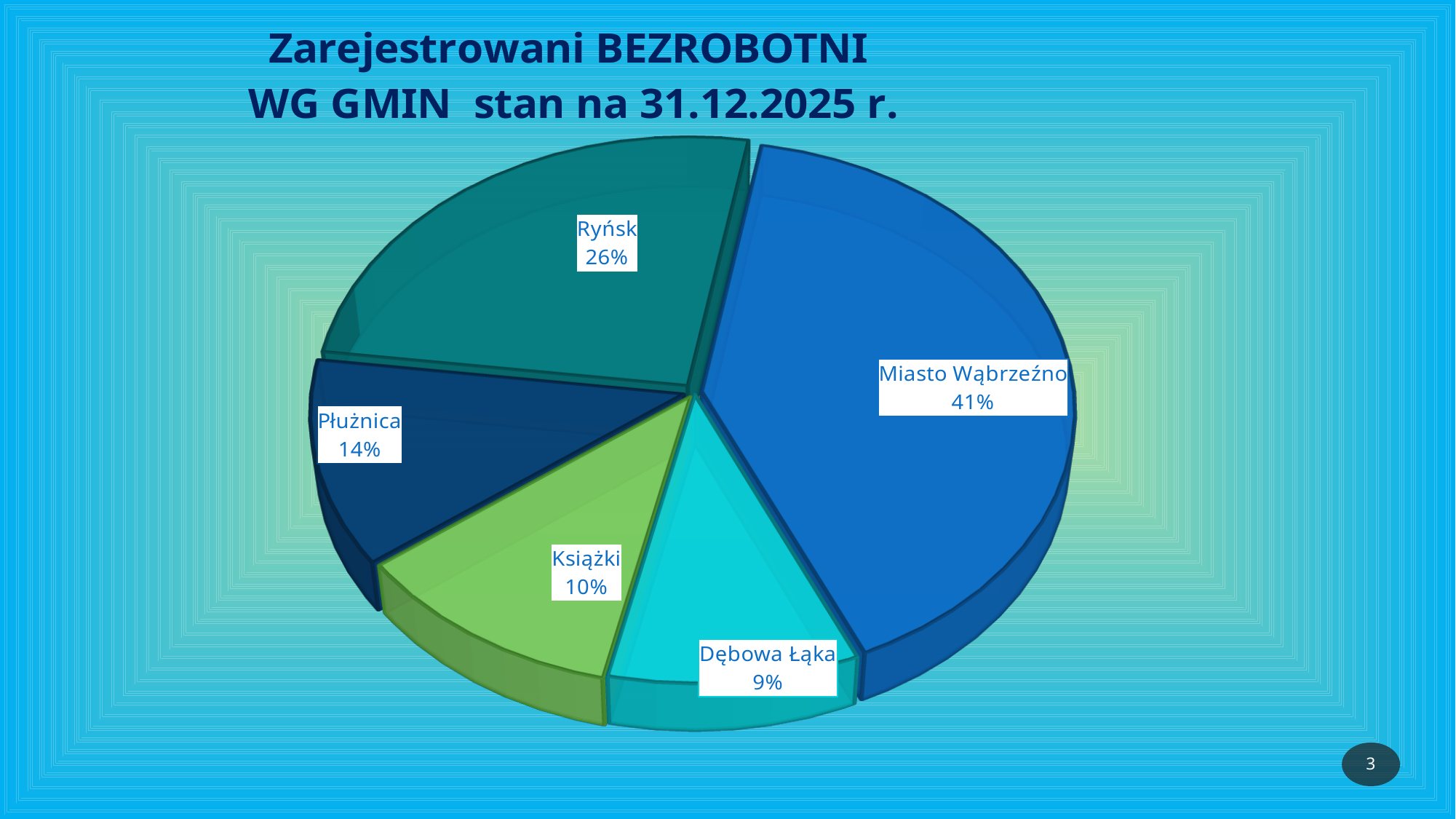
What percentage is shown for Ryńsk? 26% What is the title of the chart? Zarejestrowani BEZROBOTNI WG GMIN stan na 31.12.2025 r. Which has a larger share, Płużnica or Książki? Płużnica Which gmina has the smallest share of the pie? Dębowa Łąka What percentage is shown for Płużnica? 14% What percentage is shown for Dębowa Łąka? 9% What is the combined share of Książki and Dębowa Łąka? 19% What share of registered unemployed does Miasto Wąbrzeźno account for? 41% How many slices does the pie chart have? 5 Which gmina has the largest share of the pie? Miasto Wąbrzeźno What is the difference in percentage points between Miasto Wąbrzeźno and Ryńsk? 15 What type of chart is shown on the slide? pie chart